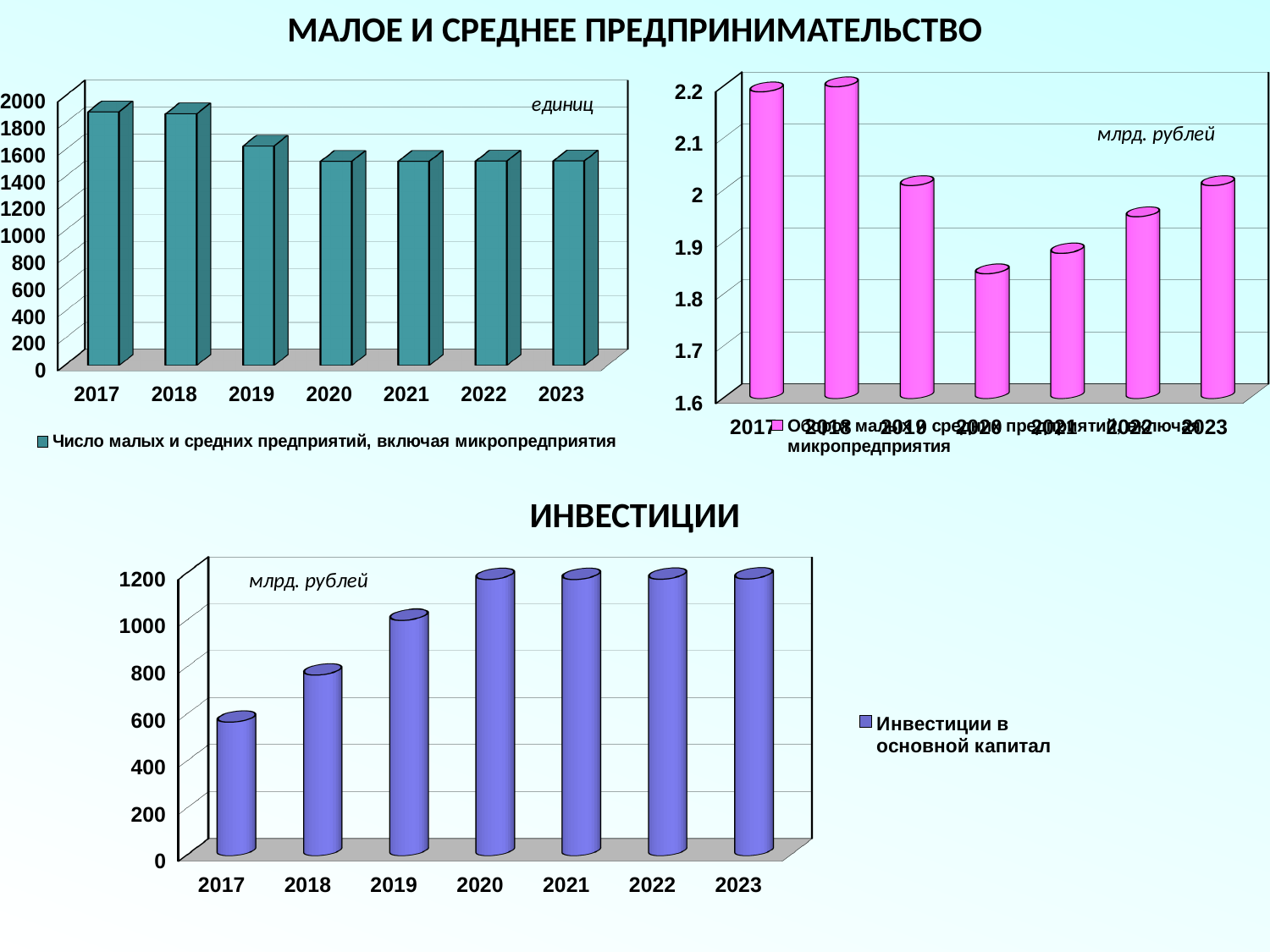
In the top-right chart, which year has the lowest value? 2020 In the bottom chart, is the value for 2018 greater or less than 800? less In the top-right chart, is the value for 2017 greater or less than 2.1? greater In the bottom chart, which year has the lowest value? 2017 In the top-left chart, do the values generally rise or fall from 2017 to 2023? fall What kind of chart is the bottom chart titled ИНВЕСТИЦИИ? bar chart In the top-left chart, is the value for 2017 greater or less than 1800? greater How many series does the legend of the bottom chart list? 1 How many years are shown on the x axis of the top-left chart? 7 In the top-left chart, which is larger, the value for 2017 or the value for 2019? 2017